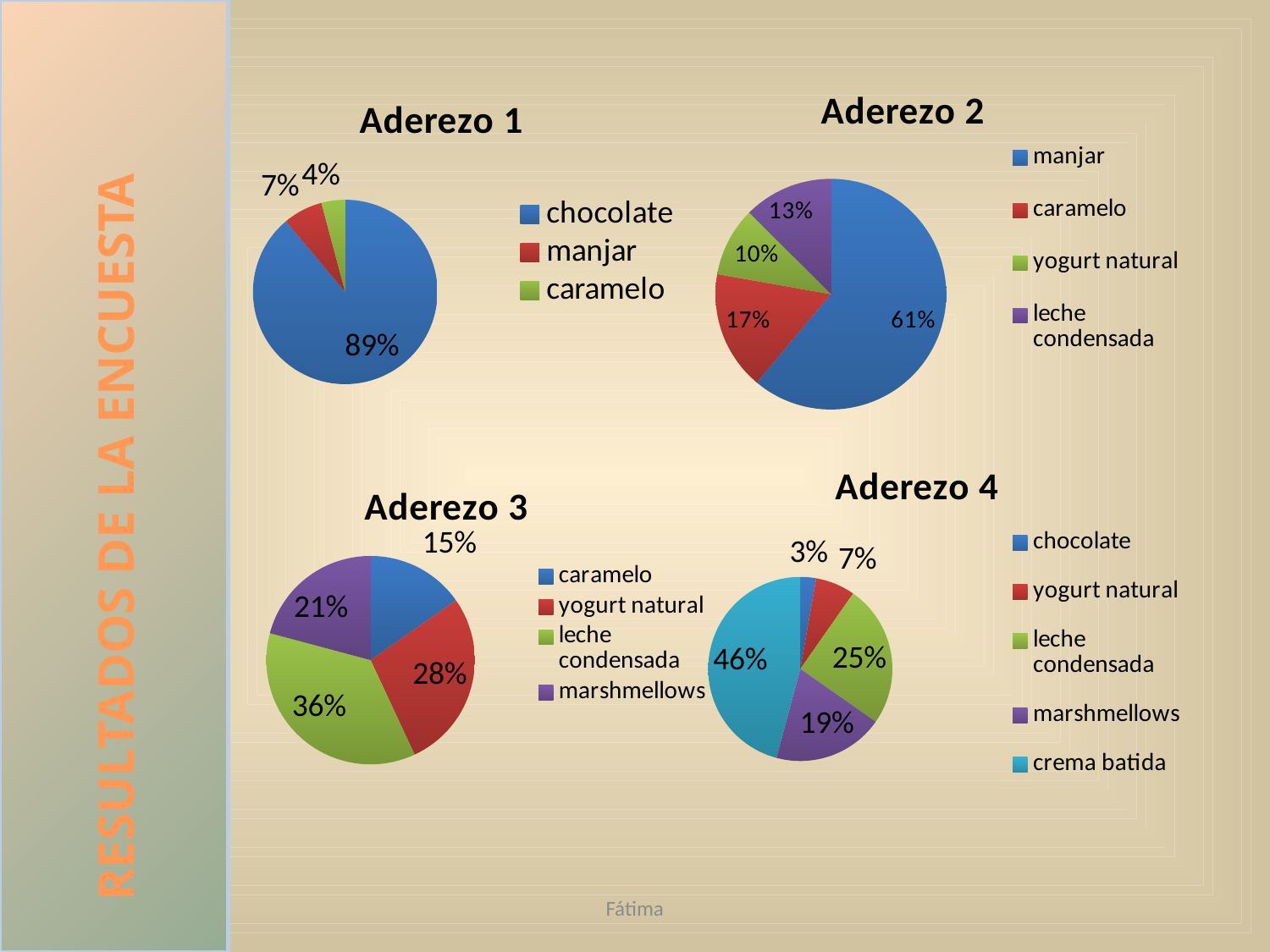
In the 'Aderezo 2' chart, what is the difference between caramelo and yogurt natural? 7% In the 'Aderezo 3' chart, what is the value for leche condensada? 36% In the 'Aderezo 4' chart, what is the difference between leche condensada and marshmellows? 6% In the 'Aderezo 3' chart, which category has the smallest slice? caramelo In the 'Aderezo 4' chart, what is the value for crema batida? 46% In the 'Aderezo 1' chart, what is the value for manjar? 7% In the 'Aderezo 4' chart, how many categories does the legend list? 5 In the 'Aderezo 2' chart, what is the value for leche condensada? 13% In the 'Aderezo 1' chart, what share does chocolate have? 89% What type of chart is 'Aderezo 1'? pie chart In the 'Aderezo 2' chart, which category has the largest slice? manjar In the 'Aderezo 3' chart, which is larger, yogurt natural or marshmellows? yogurt natural